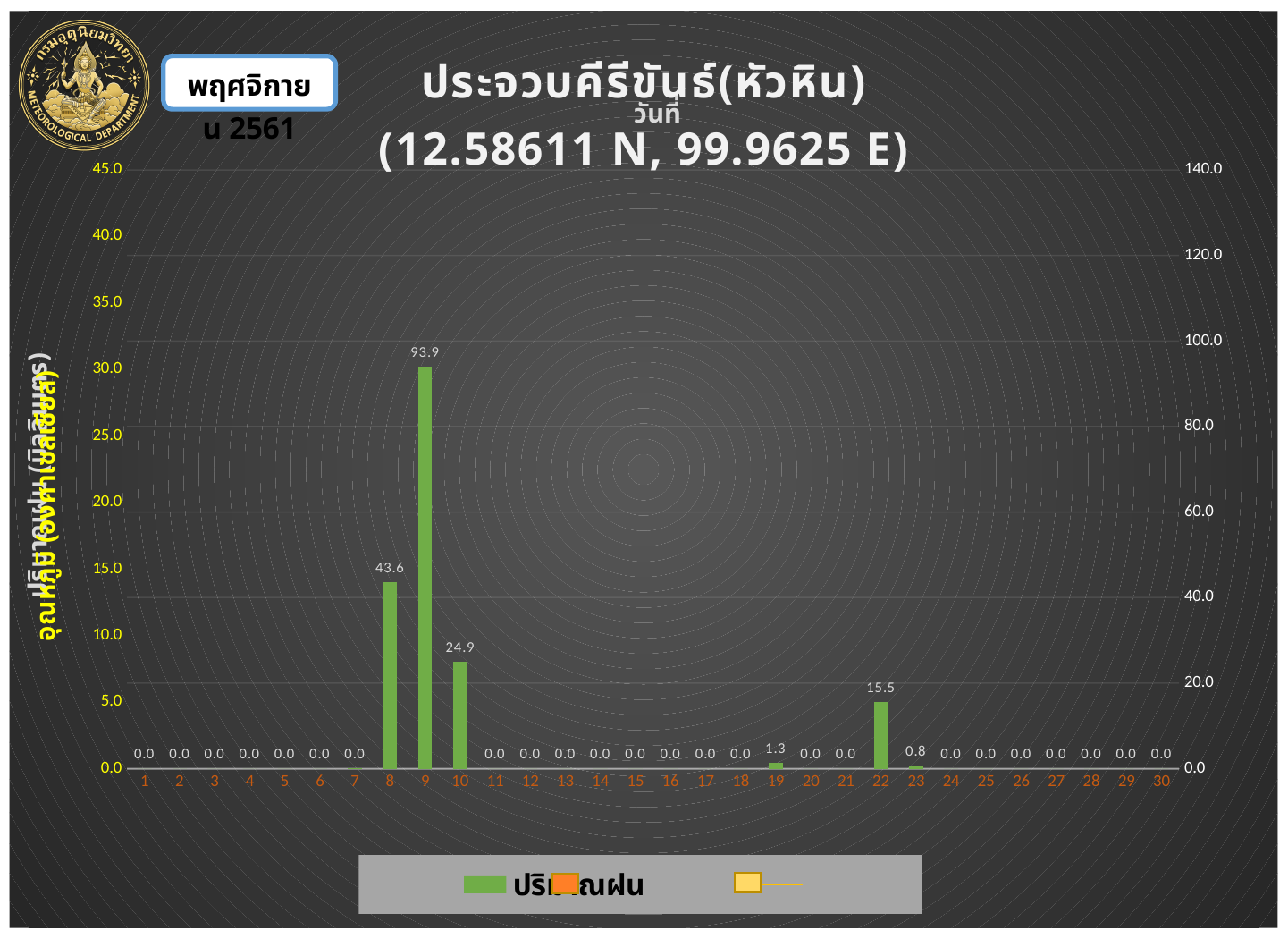
What is the rainfall value shown for day 19? 1.3 What is the rainfall value shown for day 8? 43.6 How many days have a rainfall value greater than 0.0? 6 What is the rainfall value shown for day 9? 93.9 Which has the larger rainfall value, day 8 or day 22? day 8 What is the rainfall value shown for day 22? 15.5 Which day has the highest rainfall value? 9 What is the difference between the rainfall values for day 8 and day 10? 18.7 What kind of chart is shown on the slide? bar chart How many days are shown on the x axis? 30 What is the difference between the rainfall values for day 9 and day 8? 50.3 What is the rainfall value shown for day 23? 0.8